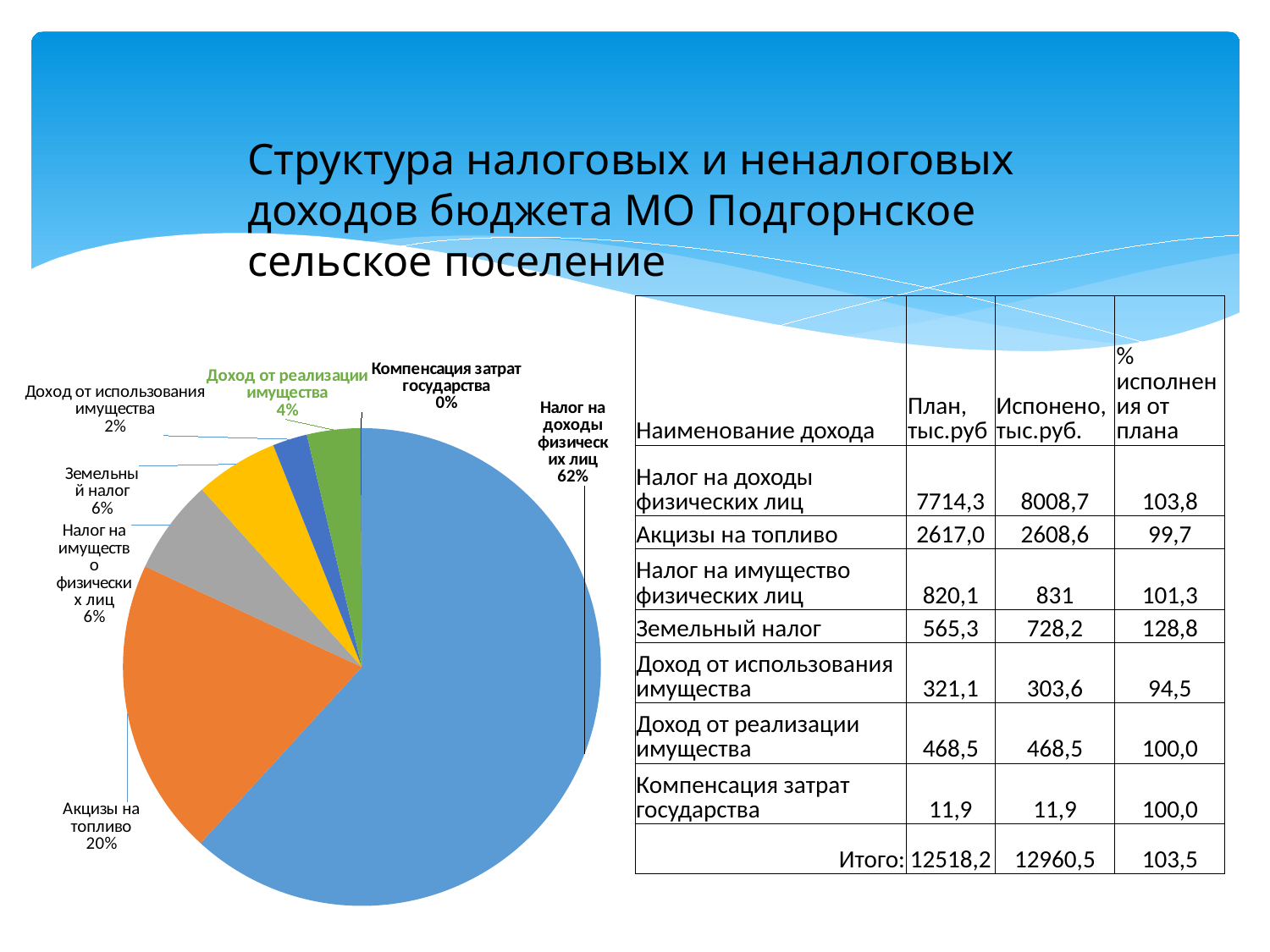
What percentage is shown for Доход от использования имущества in the pie chart? 2% Which category has the smallest slice in the pie chart? Компенсация затрат государства What share of the pie chart does Налог на доходы физических лиц represent? 62% What percentage is shown for Доход от реализации имущества in the pie chart? 4% What share of the pie chart does Акцизы на топливо represent? 20% What type of chart is shown on the slide? Pie chart Which is larger in the pie chart: Акцизы на топливо or Земельный налог? Акцизы на топливо How many slices does the pie chart have? 7 What is the difference in percentage points between Налог на доходы физических лиц and Акцизы на топливо in the pie chart? 42 What percentage is shown for Компенсация затрат государства in the pie chart? 0% What colour is the slice for Акцизы на топливо in the pie chart? Orange Which category has the largest slice in the pie chart? Налог на доходы физических лиц